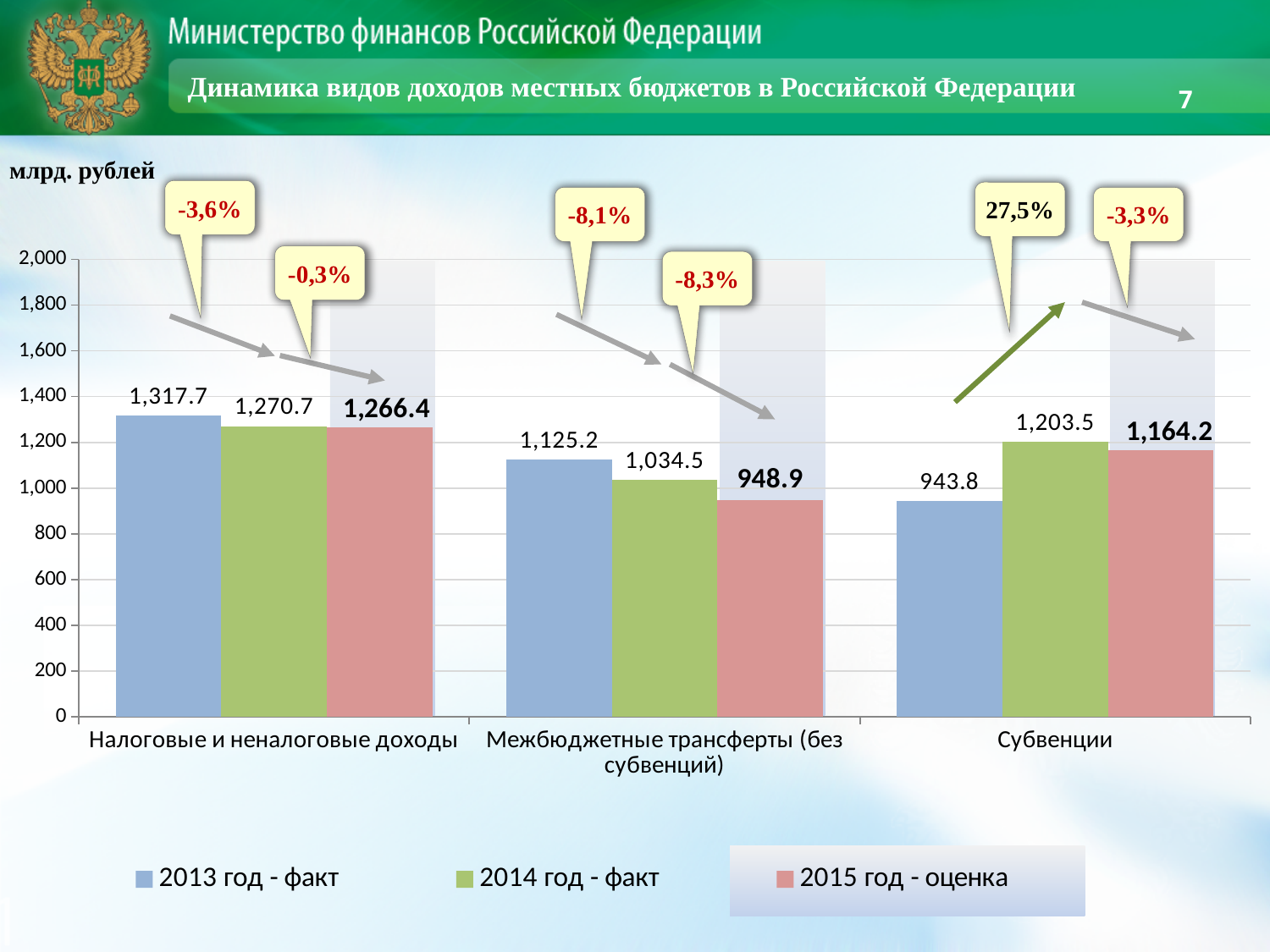
How many series does the legend list? 3 Which is larger: the 2015 год - оценка value for Субвенции or the 2015 год - оценка value for Межбюджетные трансферты (без субвенций)? Субвенции What is the value for 2013 год - факт in the Налоговые и неналоговые доходы category? 1,317.7 What is the difference between the 2013 год - факт and 2014 год - факт values in the Налоговые и неналоговые доходы category? 47.0 What is the difference between the 2014 год - факт and 2013 год - факт values in the Субвенции category? 259.7 Which category has the lowest value for 2013 год - факт? Субвенции What is the value for 2014 год - факт in the Субвенции category? 1,203.5 Is the 2013 год - факт value for Субвенции greater or less than 1,000? less What kind of chart is shown on the slide? bar chart Which category has the highest value for 2015 год - оценка? Налоговые и неналоговые доходы What is the value for 2015 год - оценка in the Межбюджетные трансферты (без субвенций) category? 948.9 How many categories are shown on the x axis? 3